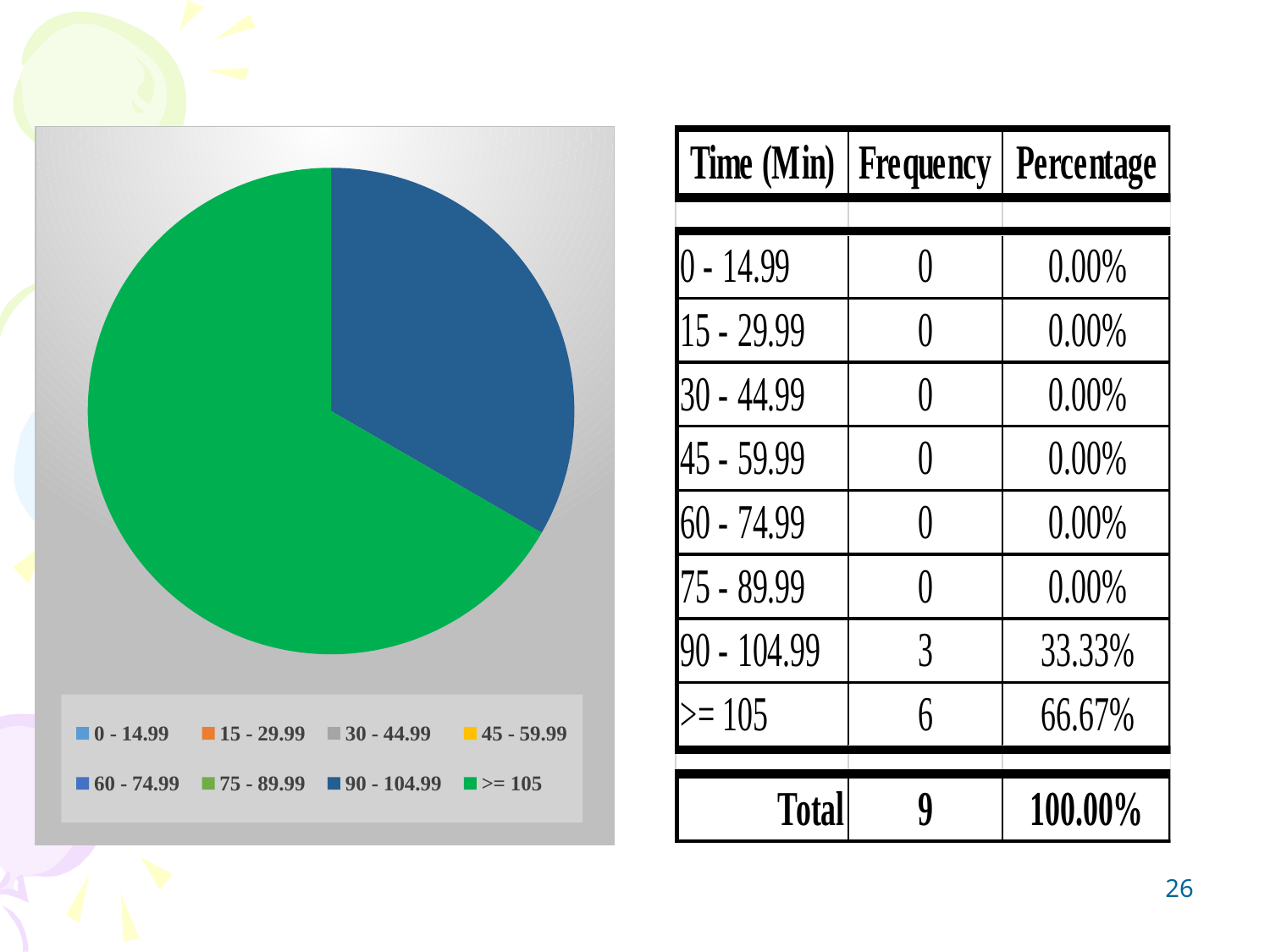
How many legend categories have a visible slice in the pie chart? 2 What is the difference in frequency between the ">= 105" and "90 - 104.99" categories? 3 How many categories does the pie chart's legend list? 8 What is the frequency for the "90 - 104.99" category in the table? 3 What is the total frequency shown in the table? 9 What kind of chart is shown on the slide? pie chart What share of the pie does the ">= 105" slice represent, according to the table on the slide? 66.67% What colour is the ">= 105" slice in the pie chart? green What is the frequency for the ">= 105" category in the table? 6 Which category has the largest slice in the pie chart? >= 105 What share of the pie does the "90 - 104.99" slice represent, according to the table on the slide? 33.33% Which of the two visible slices is larger, ">= 105" or "90 - 104.99"? >= 105